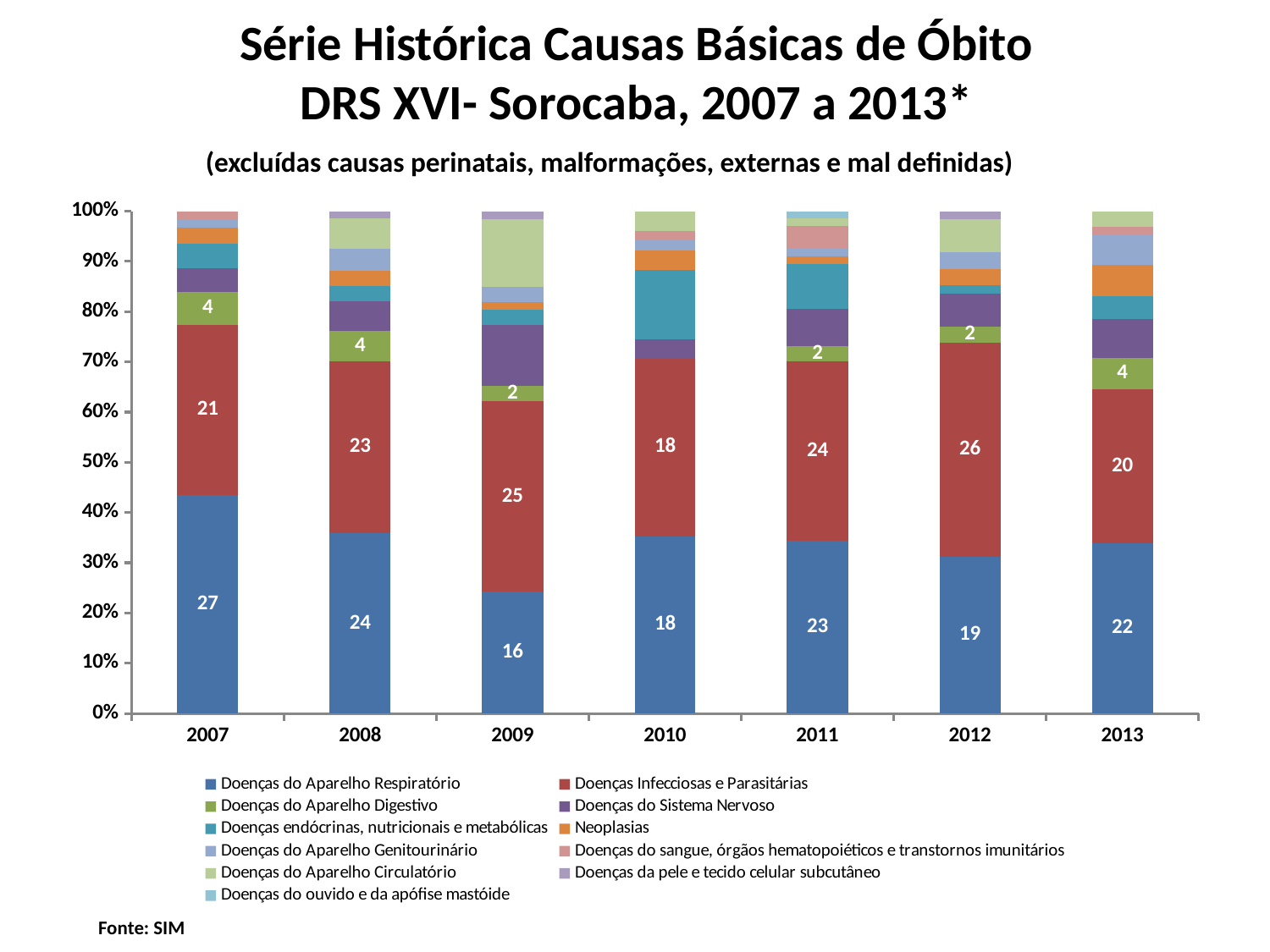
What is the data label for Doenças Infecciosas e Parasitárias in 2012? 26 In which year does Doenças Infecciosas e Parasitárias have its highest data label? 2012 What kind of chart is shown on the slide? Stacked bar chart How many years are shown on the x axis? 7 What is the data label for Doenças do Aparelho Digestivo in 2013? 4 Is the share of Doenças do Aparelho Respiratório in 2009 greater or less than 30%? less What is the source cited below the chart? SIM How many series does the legend list? 11 What is the data label for Doenças do Aparelho Respiratório in 2007? 27 In which year does Doenças do Aparelho Respiratório have its lowest data label? 2009 Which is larger in 2011: the label for Doenças do Aparelho Respiratório or for Doenças Infecciosas e Parasitárias? Doenças Infecciosas e Parasitárias What is the difference between the Doenças do Aparelho Respiratório labels for 2007 and 2009? 11